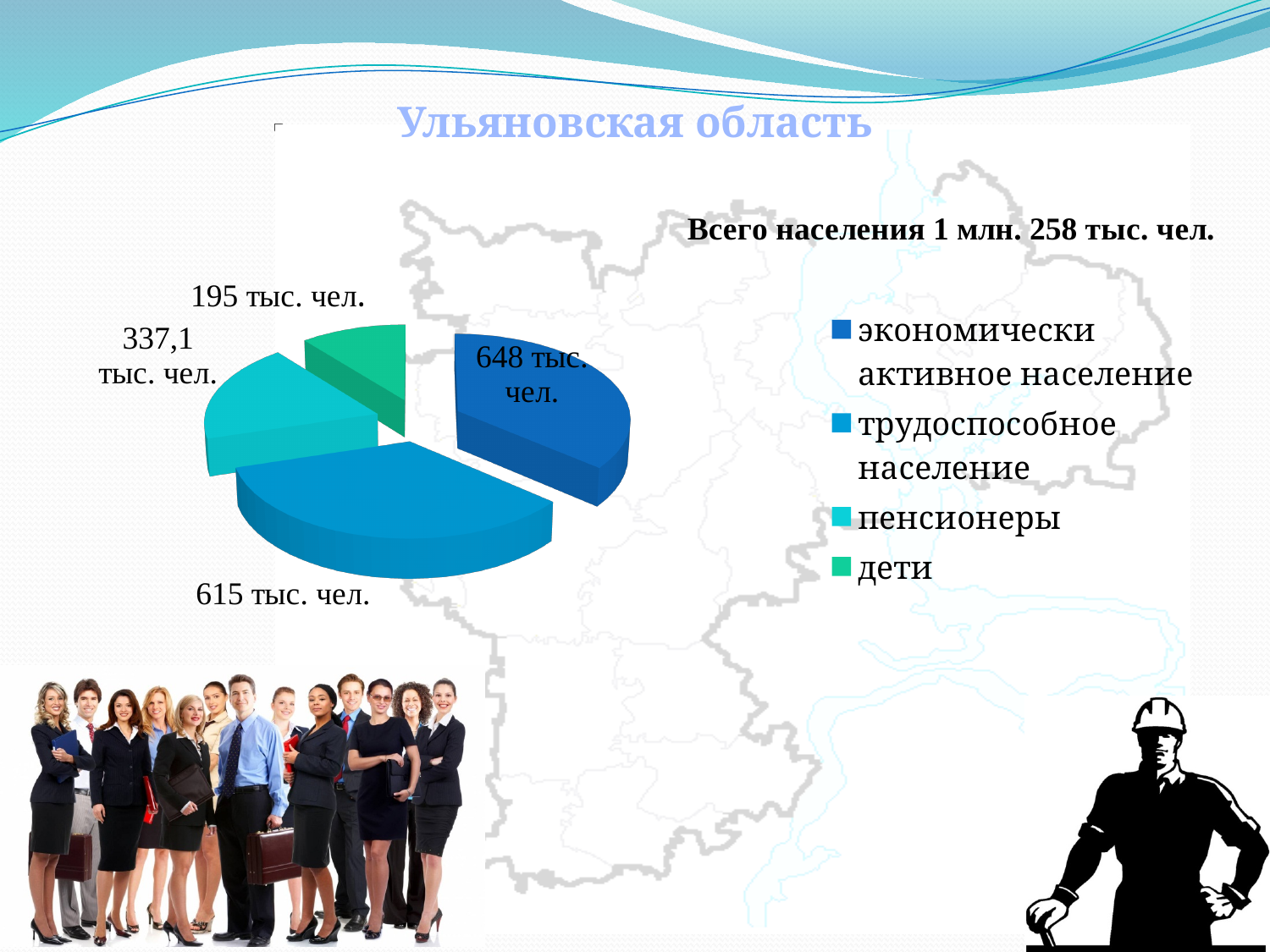
Which is larger: пенсионеры or дети? пенсионеры What type of chart is shown on the slide? pie chart Which category has the smallest value in the pie chart? дети How many slices does the pie chart have? 4 What value is shown for экономически активное население? 648 тыс. чел. How many entries does the legend of the pie chart list? 4 What value is shown for трудоспособное население? 615 тыс. чел. Which category has the largest value in the pie chart? экономически активное население What is the title of the slide containing the pie chart? Ульяновская область What value is shown for дети? 195 тыс. чел. What value is shown for пенсионеры? 337,1 тыс. чел. What is the difference between the values for экономически активное население and дети? 453 тыс. чел.